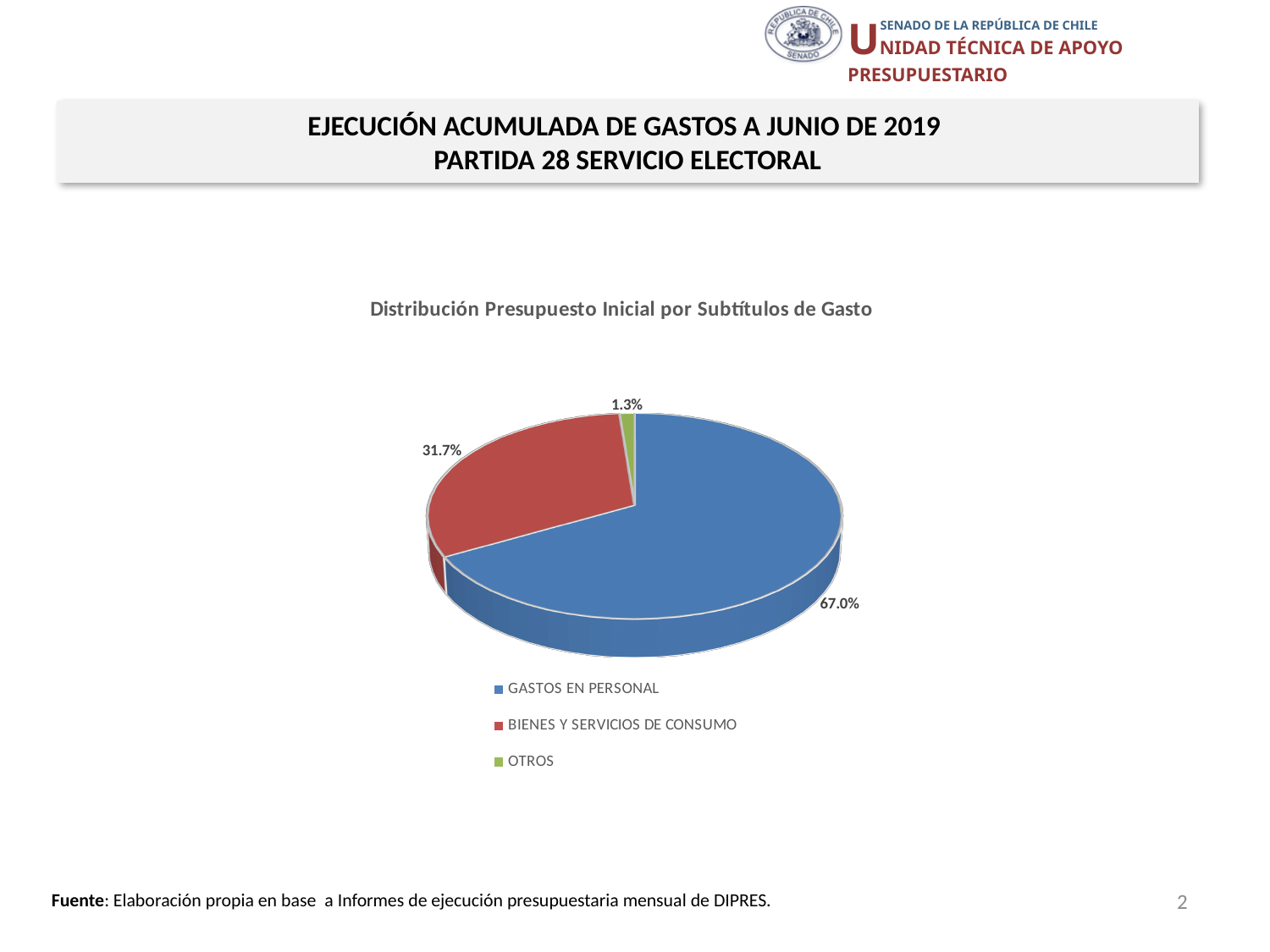
What share of the pie does OTROS represent? 1.3% What is the difference in percentage points between BIENES Y SERVICIOS DE CONSUMO and OTROS? 30.4 Which is larger, the share for BIENES Y SERVICIOS DE CONSUMO or the share for OTROS? BIENES Y SERVICIOS DE CONSUMO Which category has the largest slice of the pie? GASTOS EN PERSONAL What share of the pie does GASTOS EN PERSONAL represent? 67.0% What kind of chart is shown on the slide? Pie chart What colour is the slice for OTROS? Green Which category has the smallest slice of the pie? OTROS What is the difference in percentage points between GASTOS EN PERSONAL and BIENES Y SERVICIOS DE CONSUMO? 35.3 What share of the pie does BIENES Y SERVICIOS DE CONSUMO represent? 31.7% How many categories are shown in the pie chart? 3 What is the title of the chart? Distribución Presupuesto Inicial por Subtítulos de Gasto